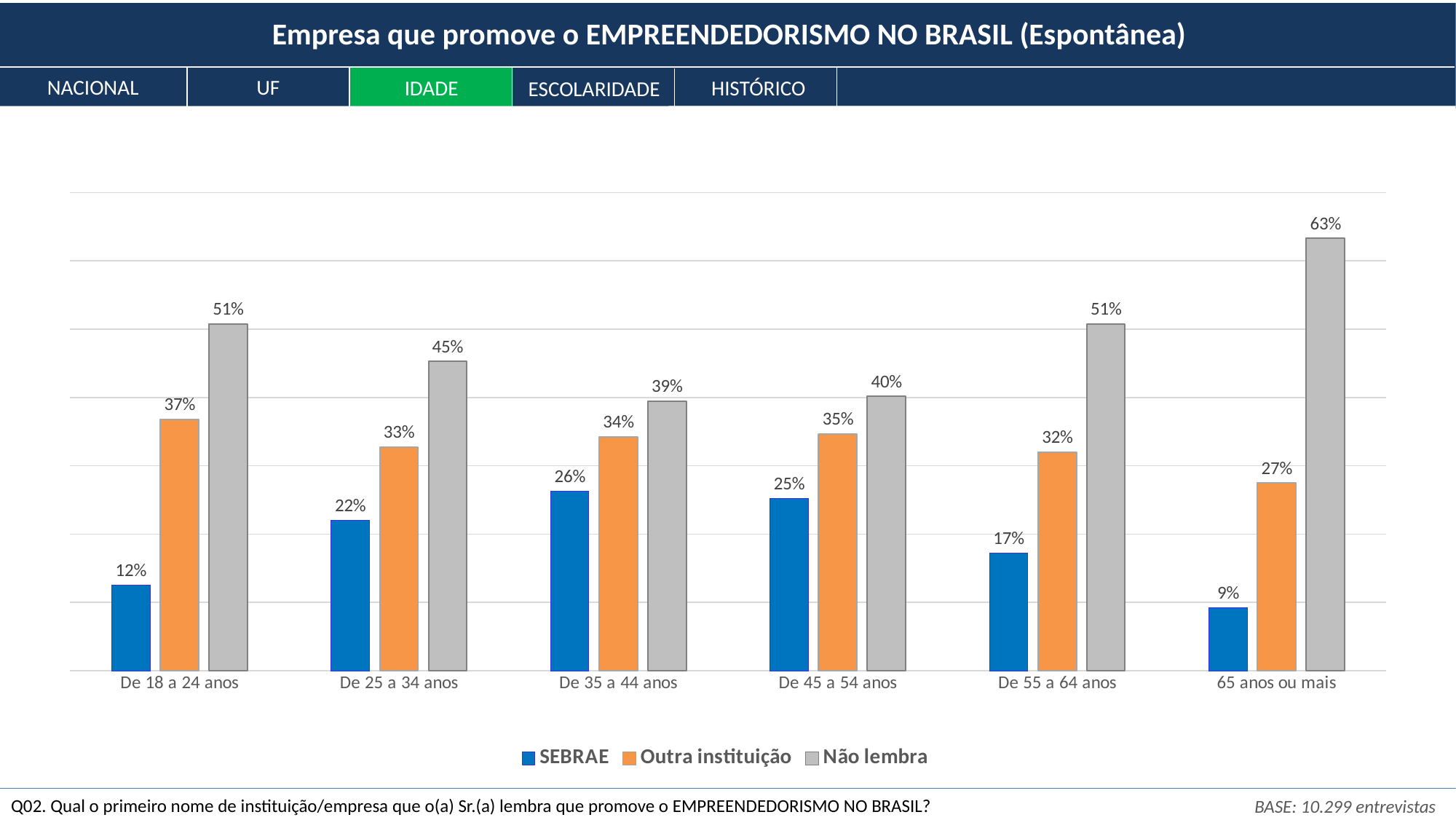
What is the difference between the 'Não lembra' and SEBRAE values for the 'De 18 a 24 anos' age group? 39% Which is larger for the 'De 55 a 64 anos' age group: SEBRAE or 'Outra instituição'? Outra instituição How many age groups are shown on the x axis? 6 What is the SEBRAE value for the 'De 35 a 44 anos' age group? 26% Which age group has the highest SEBRAE value? De 35 a 44 anos Which age group has the lowest SEBRAE value? 65 anos ou mais Which colour represents the SEBRAE series in the legend? Blue How many series does the legend list? 3 What is the 'Não lembra' value for the '65 anos ou mais' age group? 63% What is the 'Outra instituição' value for the 'De 18 a 24 anos' age group? 37% What kind of chart is shown on the slide? Bar chart Which age group has the highest 'Não lembra' value? 65 anos ou mais